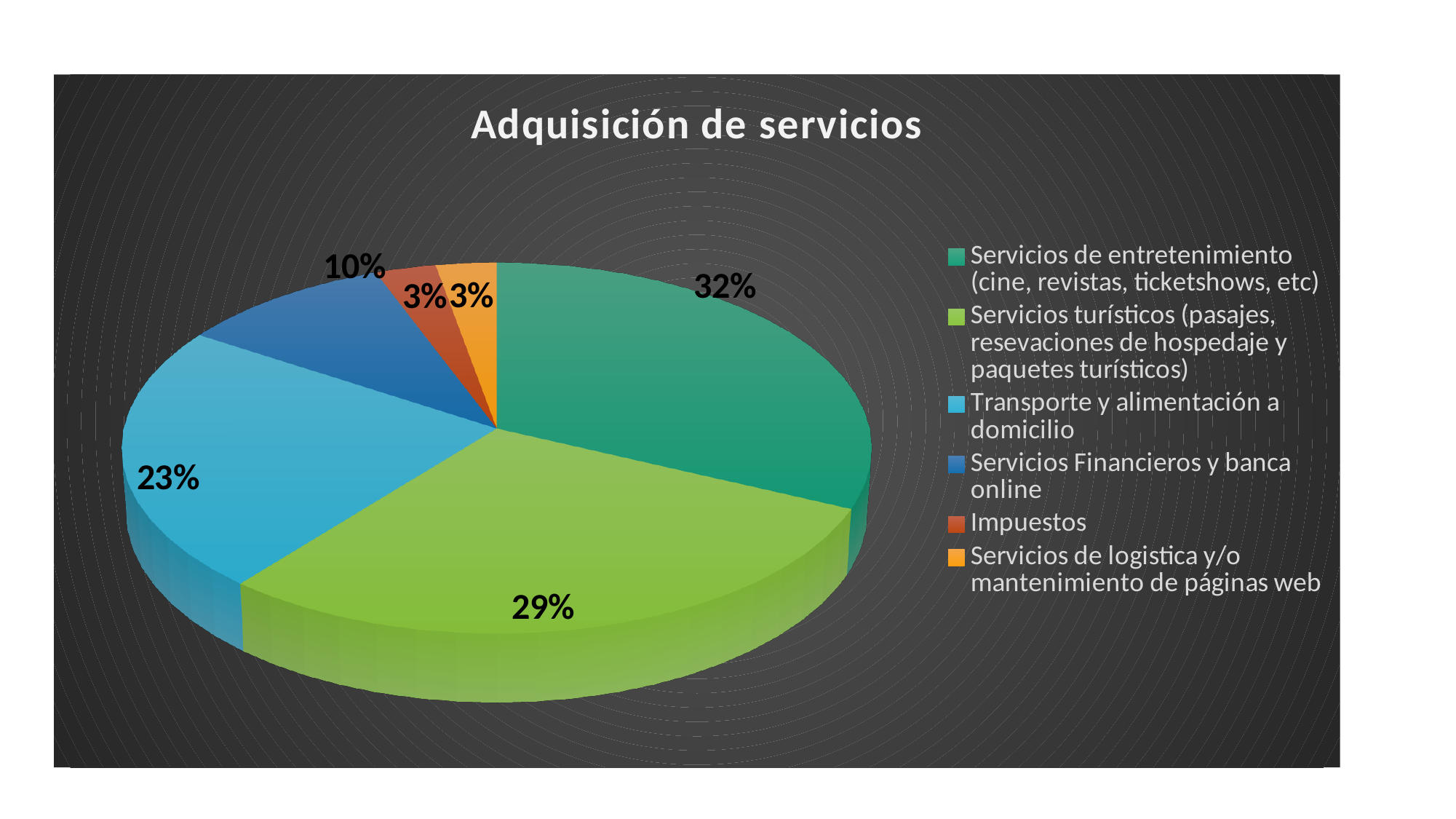
Which is larger, the share for Servicios turísticos or the share for Servicios Financieros y banca online? Servicios turísticos What is the title of the chart? Adquisición de servicios Which category has the largest share of the pie? Servicios de entretenimiento (cine, revistas, ticketshows, etc) What share of the pie is Servicios de entretenimiento (cine, revistas, ticketshows, etc)? 32% What share of the pie is Servicios turísticos (pasajes, resevaciones de hospedaje y paquetes turísticos)? 29% What share of the pie is Servicios Financieros y banca online? 10% How many categories does the legend list? 6 What type of chart is shown on the slide? Pie chart What colour is the slice for Impuestos? Red-brown What is the difference in percentage points between Servicios de entretenimiento and Transporte y alimentación a domicilio? 9 percentage points